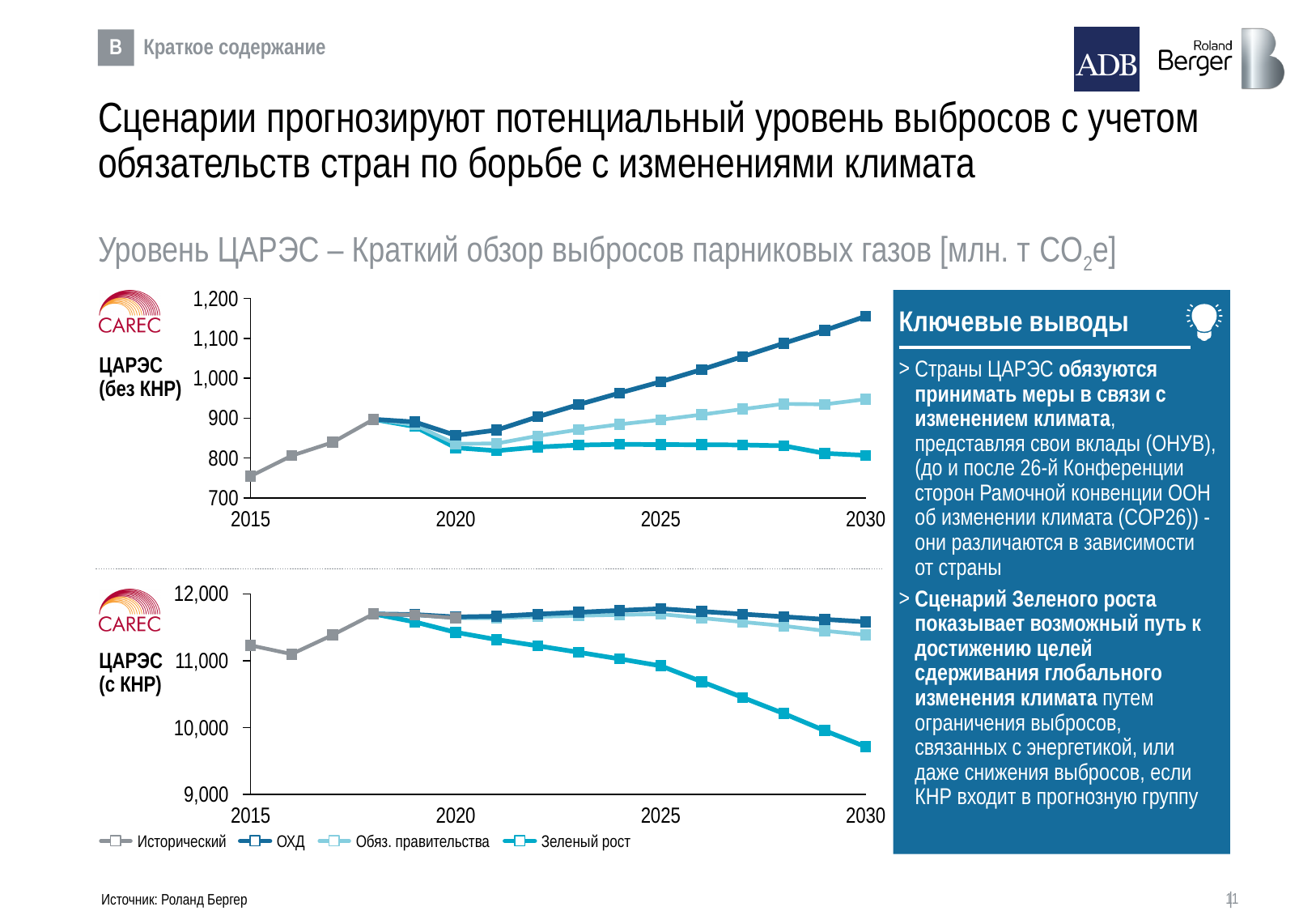
What is the first year shown on the x axis of the top chart (ЦАРЭС без КНР)? 2015 What kind of chart is the top chart (ЦАРЭС без КНР)? line chart In the top chart (ЦАРЭС без КНР), is the value of ОХД in 2030 greater or less than 1,100? greater In the bottom chart (ЦАРЭС с КНР), which is larger in 2030: Обяз. правительства or Зеленый рост? Обяз. правительства In the bottom chart (ЦАРЭС с КНР), is the value of Зеленый рост in 2030 greater or less than 10,000? less In the top chart (ЦАРЭС без КНР), is the value of Зеленый рост in 2030 greater or less than 900? less In the top chart (ЦАРЭС без КНР), does the ОХД series rise or fall from 2020 to 2030? rise How many series does the legend list for the charts? 4 In the bottom chart (ЦАРЭС с КНР), does the Зеленый рост series rise or fall from 2020 to 2030? fall In the top chart (ЦАРЭС без КНР), which series has the highest value in 2030? ОХД In the bottom chart (ЦАРЭС с КНР), which series has the lowest value in 2030? Зеленый рост